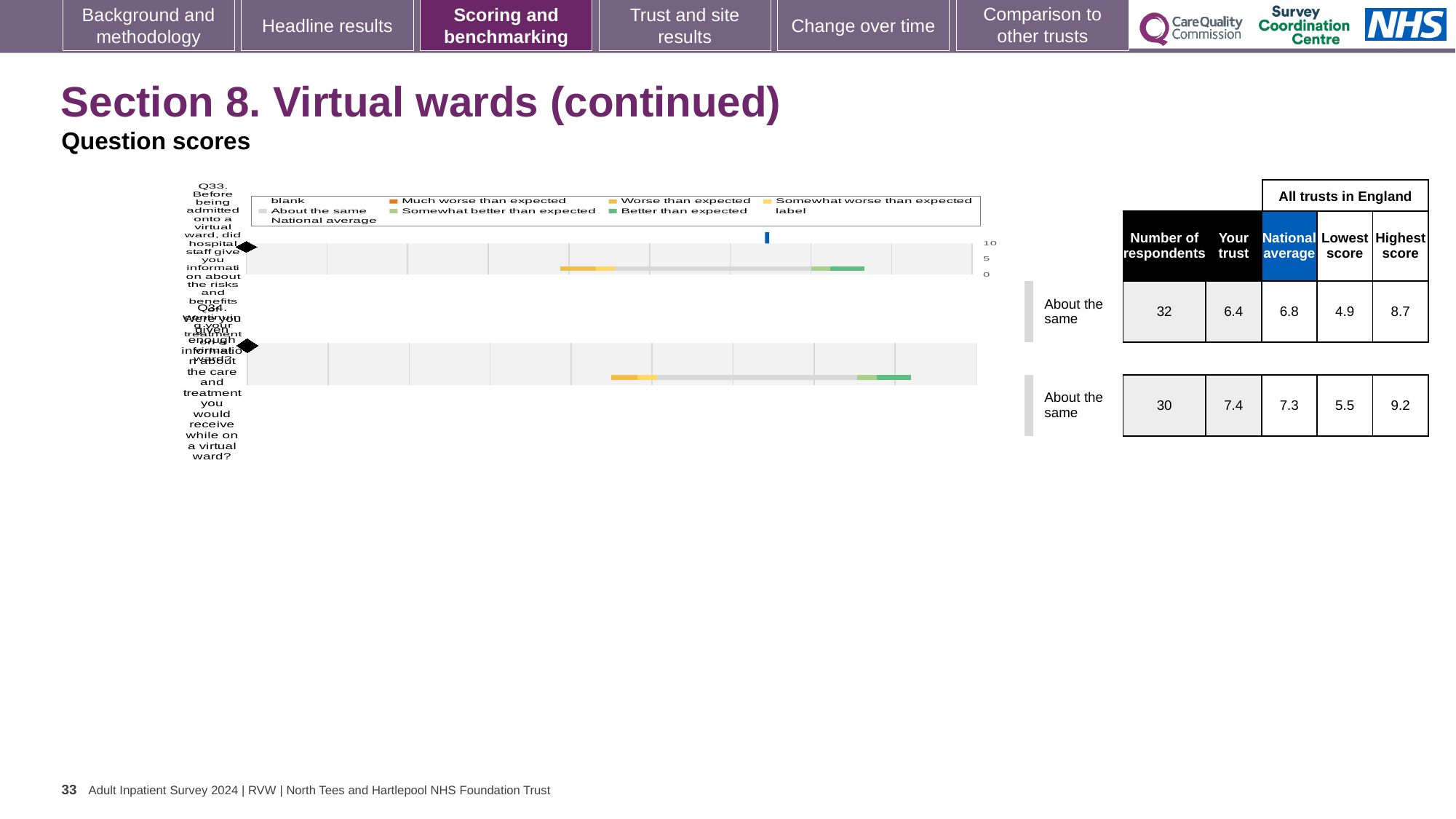
What is the difference between the highest score and the lowest score for Q34? 3.7 What is the 'Your trust' score for Q33? 6.4 How many questions (bars) are plotted in the chart? 2 For Q33, which is larger: the 'Your trust' score or the national average? National average What is the number of respondents for Q34? 30 What is the highest score among all trusts in England for Q33? 8.7 What is the national average for Q34? 7.3 What benchmark category is shown for Q33 next to the chart? About the same What kind of chart is shown on the slide? bar chart Which colour does the legend use for 'Much worse than expected'? orange What is the lowest score among all trusts in England for Q34? 5.5 What is the number of respondents for Q33? 32